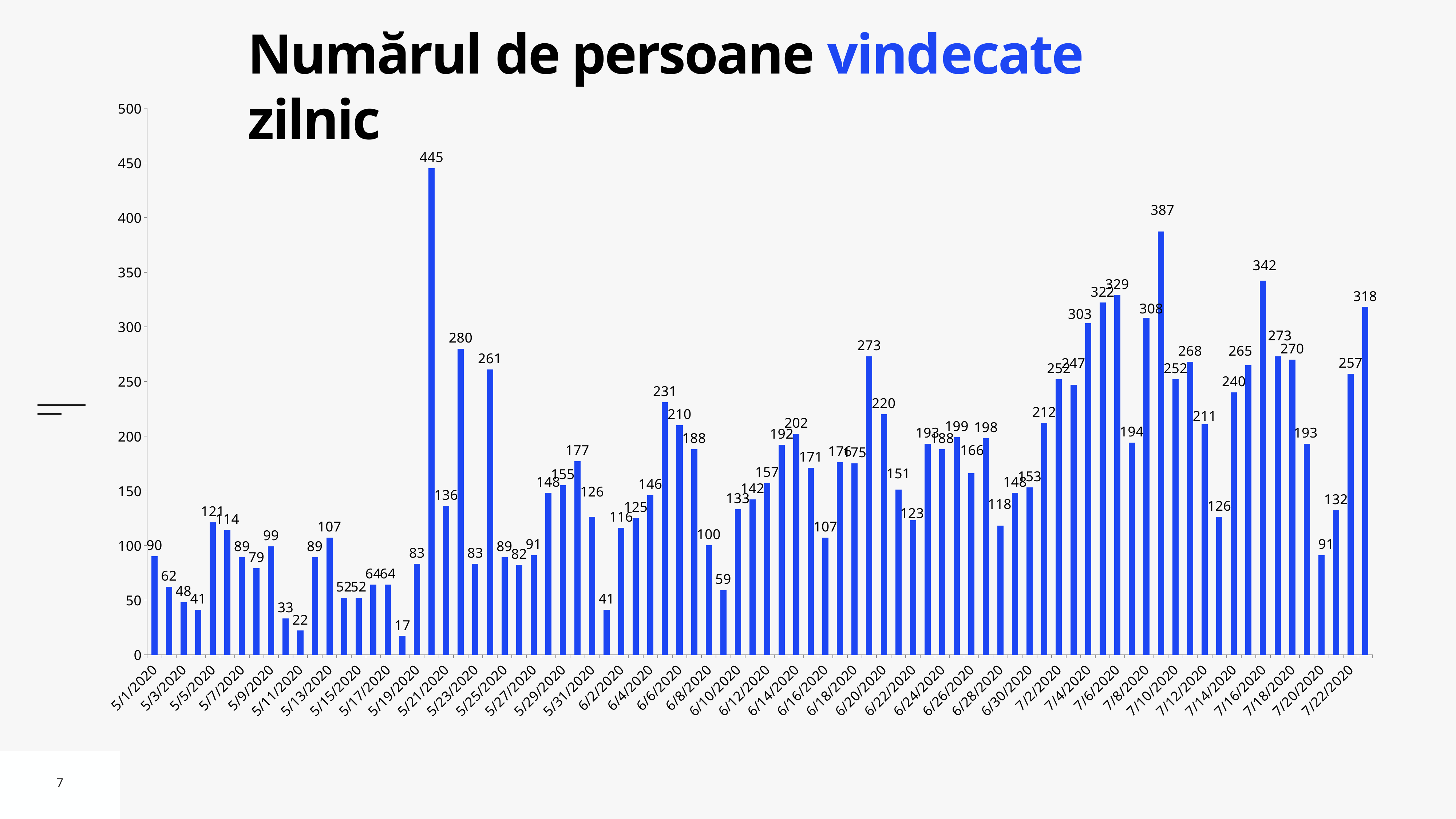
What is the lowest value shown on the chart? 17 What is the title of the chart? Numărul de persoane vindecate zilnic Which is larger, the value for 6/6/2020 or the value for 6/14/2020? 6/6/2020 What is the value for 6/20/2020? 220 What is the value for 5/5/2020? 121 What is the difference between the values for 7/6/2020 and 7/4/2020? 26 What is the value for 7/16/2020? 342 What is the value for 7/4/2020? 303 What kind of chart is shown on the slide? bar chart Is the value for 5/11/2020 greater or less than 50? less Do the values rise or fall from 5/1/2020 to 5/3/2020? fall What is the highest value shown on the chart? 445